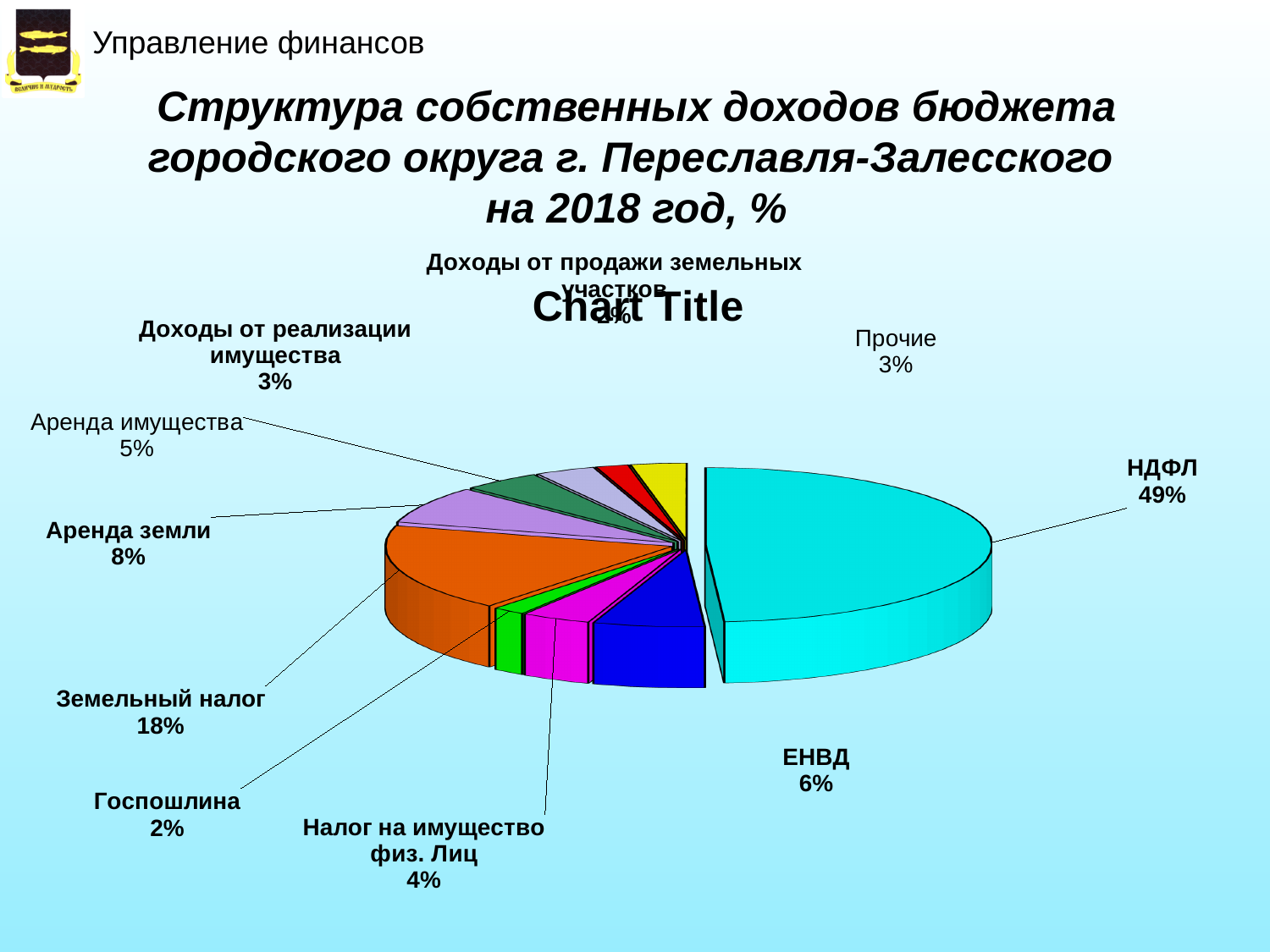
Which is larger, the share of ЕНВД or the share of Аренда земли? Аренда земли What is the value for Аренда земли? 8% What share of the budget's own revenues does НДФЛ account for? 49% What type of chart is shown on the slide? pie chart What is the difference between the shares of НДФЛ and Земельный налог? 31% Which category has the largest slice of the pie? НДФЛ What is the value shown for Аренда имущества? 5% What percentage is shown for Налог на имущество физ. Лиц? 4% How many categories (slices) does the pie chart have? 10 What placeholder title text is printed over the pie chart? Chart Title What percentage is shown for ЕНВД? 6% What is the value shown for Земельный налог? 18%